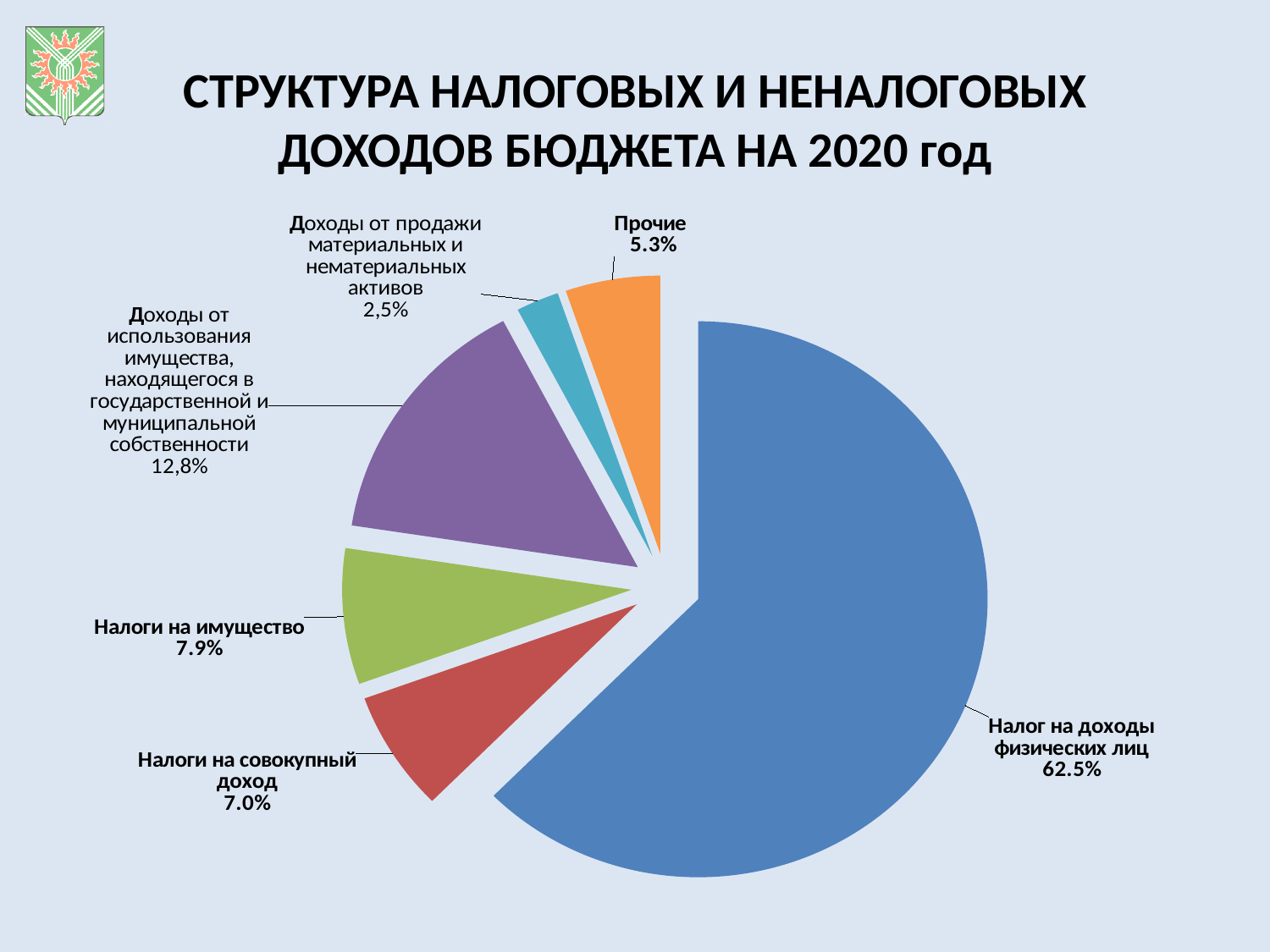
Which is larger: "Налоги на имущество" or "Налоги на совокупный доход"? Налоги на имущество How many slices does the pie chart have? 6 What is the difference between the shares of "Налог на доходы физических лиц" and "Прочие"? 57.2% What is the value shown for "Налоги на совокупный доход"? 7.0% What share of the pie does "Налог на доходы физических лиц" have? 62.5% What is the value shown for "Прочие"? 5.3% Which category has the smallest slice of the pie? Доходы от продажи материальных и нематериальных активов Which category has the largest slice of the pie? Налог на доходы физических лиц What is the value shown for "Доходы от использования имущества, находящегося в государственной и муниципальной собственности"? 12,8% What is the title of the chart on the slide? СТРУКТУРА НАЛОГОВЫХ И НЕНАЛОГОВЫХ ДОХОДОВ БЮДЖЕТА НА 2020 год What kind of chart is shown on the slide? pie chart What is the value shown for "Налоги на имущество"? 7.9%